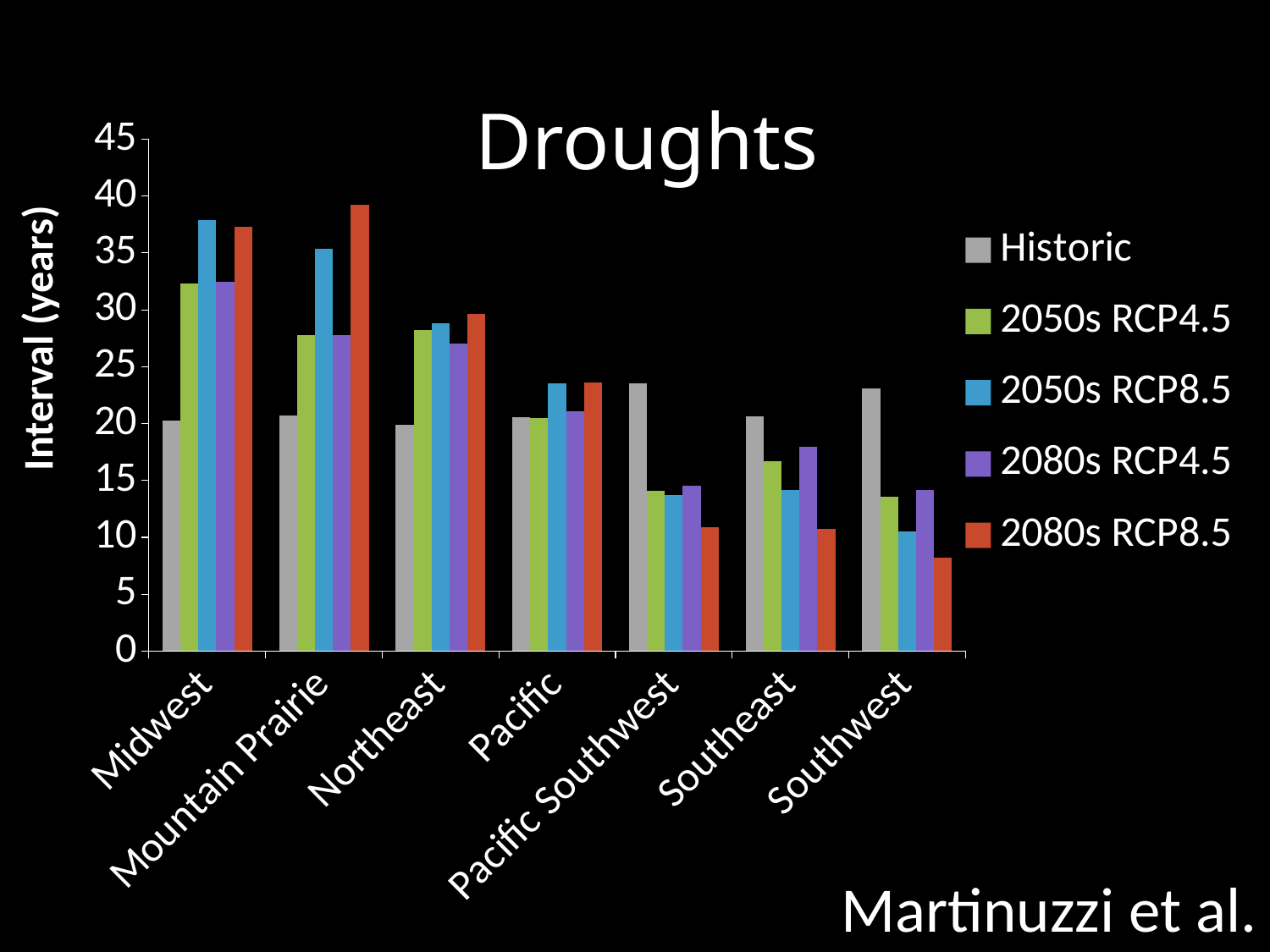
What is the title of the chart? Droughts How many series does the legend list? 5 Is the 2080s RCP8.5 value for Southeast greater or less than 15? less How many regions are shown on the x axis of the chart? 7 Which region has the lowest 2080s RCP8.5 value? Southwest Is the 2050s RCP8.5 value for Midwest greater or less than 35? greater What kind of chart is shown on the slide? bar chart Is the 2080s RCP8.5 value for Southwest greater or less than 10? less For Pacific Southwest, which is larger: the Historic value or the 2080s RCP8.5 value? Historic What is the label on the y axis of the chart? Interval (years) Which region has the highest 2080s RCP8.5 value? Mountain Prairie